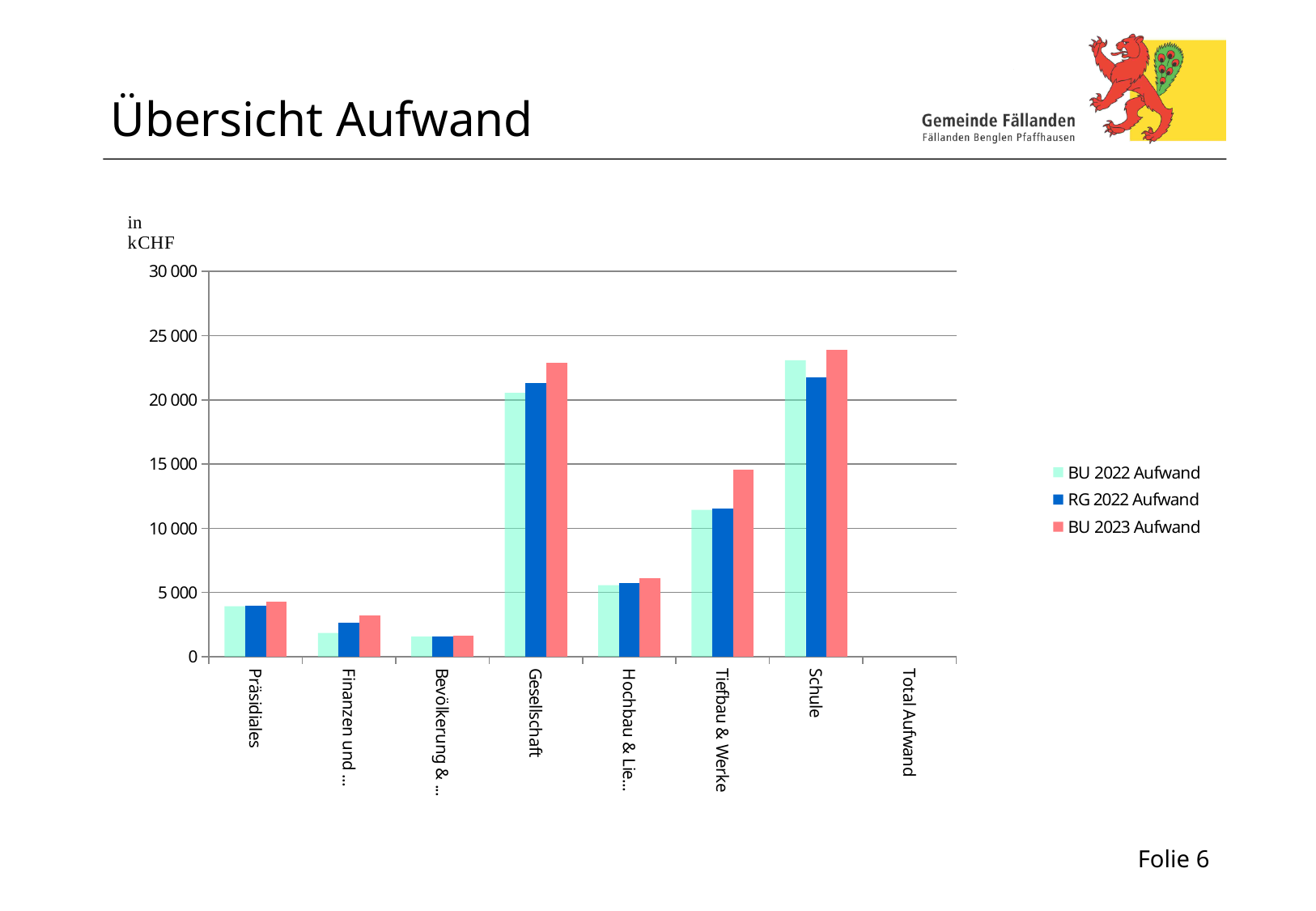
For Tiefbau & Werke, which is larger: RG 2022 Aufwand or BU 2023 Aufwand? BU 2023 Aufwand What kind of chart is shown on the slide? bar chart Which category has the highest BU 2023 Aufwand value? Schule How many categories are shown on the x axis? 8 For Schule, which is larger: BU 2022 Aufwand or RG 2022 Aufwand? BU 2022 Aufwand What unit is indicated for the y axis of the chart? in kCHF Is the BU 2023 Aufwand value for Hochbau & Lie... greater or less than 5 000? greater Which category has the lowest RG 2022 Aufwand value among those with bars? Bevölkerung & ... Is the BU 2022 Aufwand value for Gesellschaft greater or less than 20 000? greater Is the BU 2023 Aufwand value for Präsidiales greater or less than 5 000? less How many series does the legend list? 3